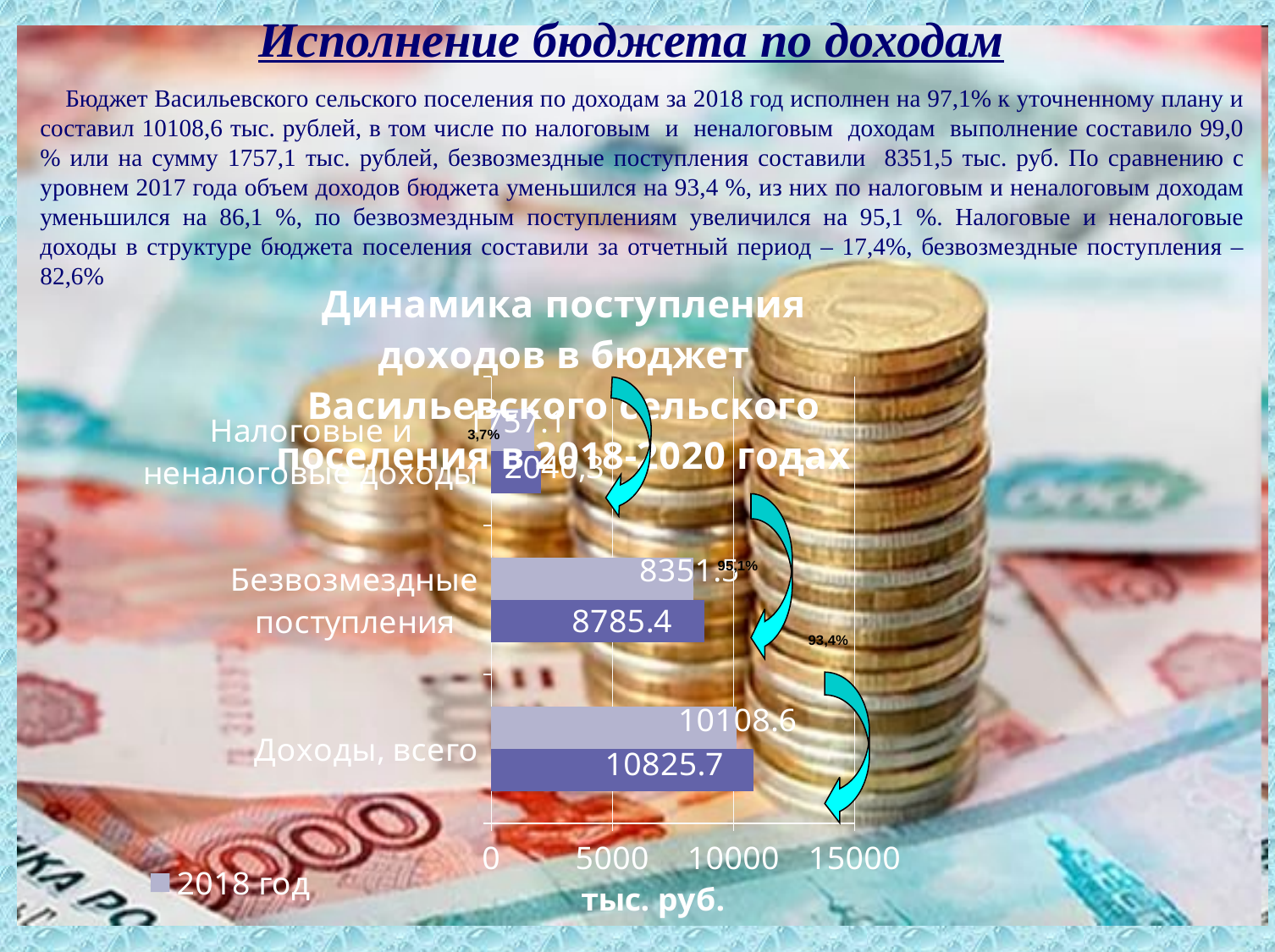
What is the 2018 value for Доходы, всего? 10108.6 Which category has the lowest values? Налоговые и неналоговые доходы What is the 2018 value for Безвозмездные поступления? 8351.5 What is the value of the darker bar for Безвозмездные поступления? 8785.4 What is the difference between the 2018 values for Доходы, всего and Безвозмездные поступления? 1757.1 What is the value of the darker bar for Доходы, всего? 10825.7 How many categories are shown on the chart? 3 Which category has the highest values? Доходы, всего For Доходы, всего, which bar is longer, the lighter one or the darker one? the darker one What unit is shown on the horizontal axis of the chart? тыс. руб. What kind of chart is shown on the slide? bar chart Is the 2018 value for Безвозмездные поступления greater or less than 5000? greater